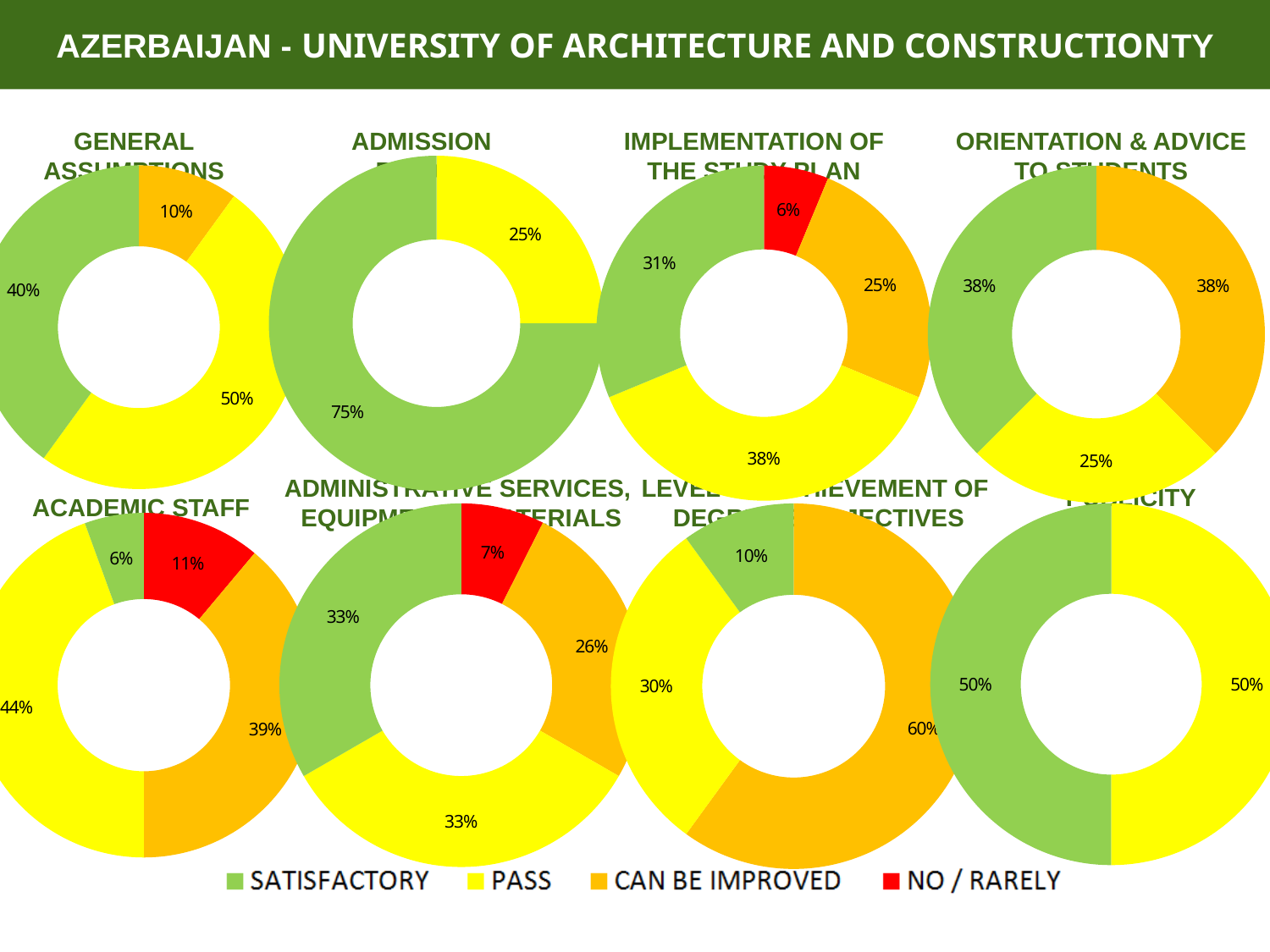
In the Academic Staff chart, which category has the smallest share? Satisfactory In the General Assumptions chart, what percentage is Can Be Improved? 10% In the General Assumptions chart, what percentage is Pass? 50% In the Academic Staff chart, what percentage is No / Rarely? 11% In the Orientation & Advice to Students chart, what percentage is Pass? 25% In the Implementation of the Study Plan chart, what percentage is No / Rarely? 6% In the Academic Staff chart, what is the difference between Pass and Can Be Improved? 5% What kind of chart is used on this slide? Doughnut chart In the Implementation of the Study Plan chart, which category has the largest share? Pass In the Admission chart, what percentage is Satisfactory? 75% In the Level of Achievement of Degree Objectives chart, what percentage is Can Be Improved? 60% How many series does the legend list? 4